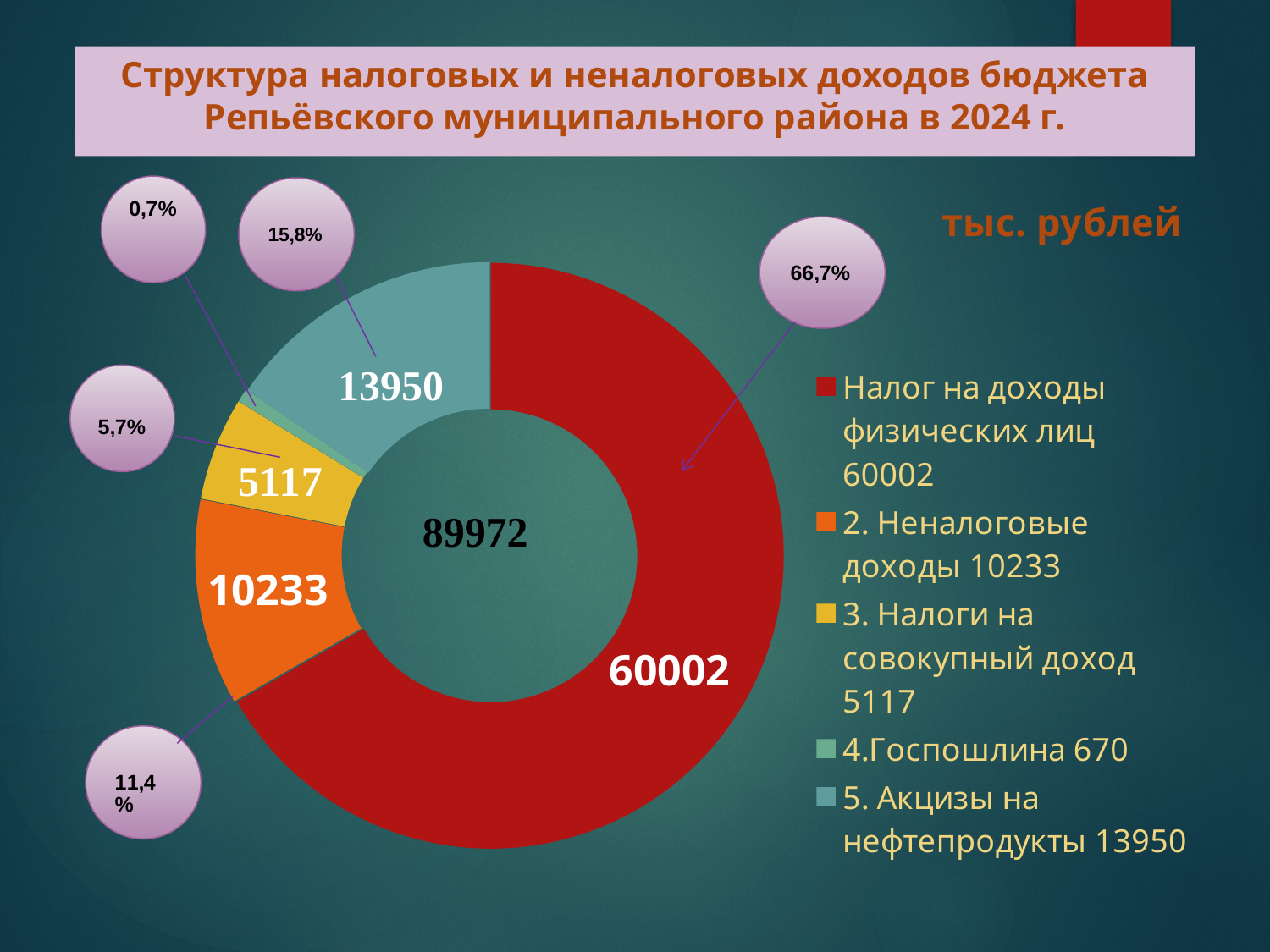
How many categories does the legend list? 5 What is the value for «Неналоговые доходы»? 10233 What type of chart is shown on the slide? doughnut (pie) chart What is the value for «Госпошлина»? 670 What is the value for «Налог на доходы физических лиц»? 60002 Which is larger: «Налоги на совокупный доход» or «Неналоговые доходы»? Неналоговые доходы What is the difference between «Акцизы на нефтепродукты» and «Неналоговые доходы»? 3717 Which category has the smallest value? Госпошлина What is the value for «Акцизы на нефтепродукты»? 13950 What share of the total does «Налог на доходы физических лиц» represent? 66,7% Which category has the largest value? Налог на доходы физических лиц What total value is shown in the centre of the doughnut? 89972